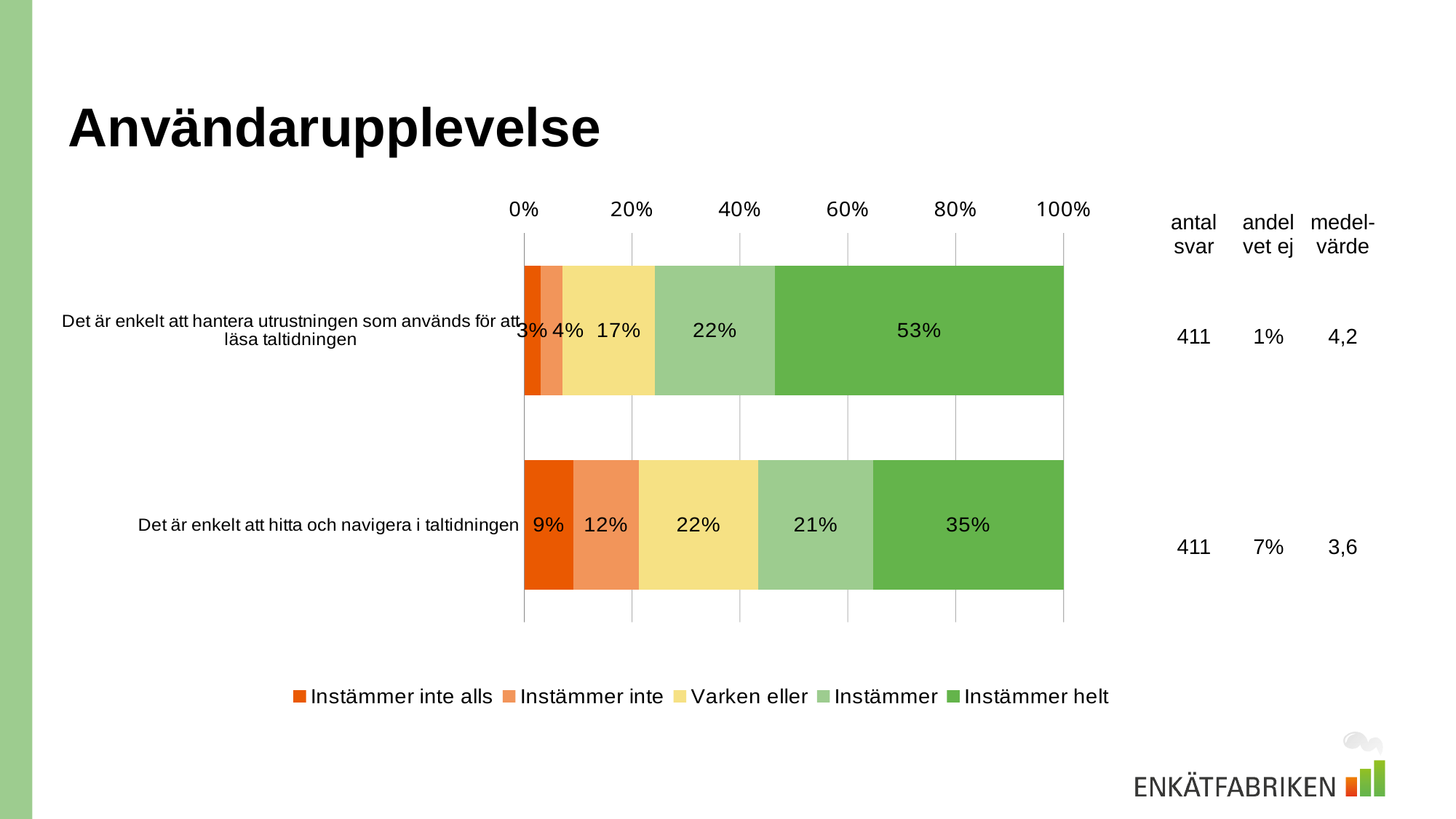
What is the value for "Varken eller" for "Det är enkelt att hitta och navigera i taltidningen"? 22% Which statement has the higher value for "Instämmer helt"? Det är enkelt att hantera utrustningen som används för att läsa taltidningen Which series has the lowest value for "Det är enkelt att hantera utrustningen som används för att läsa taltidningen"? Instämmer inte alls How many categories (statements) are plotted in the chart? 2 What is the value for "Instämmer inte" for "Det är enkelt att hantera utrustningen som används för att läsa taltidningen"? 4% What is the title of the slide containing the chart? Användarupplevelse What is the difference between the "Instämmer helt" values of the two statements? 18% How many series does the legend list? 5 What is the value for "Instämmer helt" for "Det är enkelt att hantera utrustningen som används för att läsa taltidningen"? 53% Which series has the highest value for "Det är enkelt att hitta och navigera i taltidningen"? Instämmer helt What kind of chart is shown on the slide? Stacked bar chart What is the value for "Instämmer inte alls" for "Det är enkelt att hitta och navigera i taltidningen"? 9%